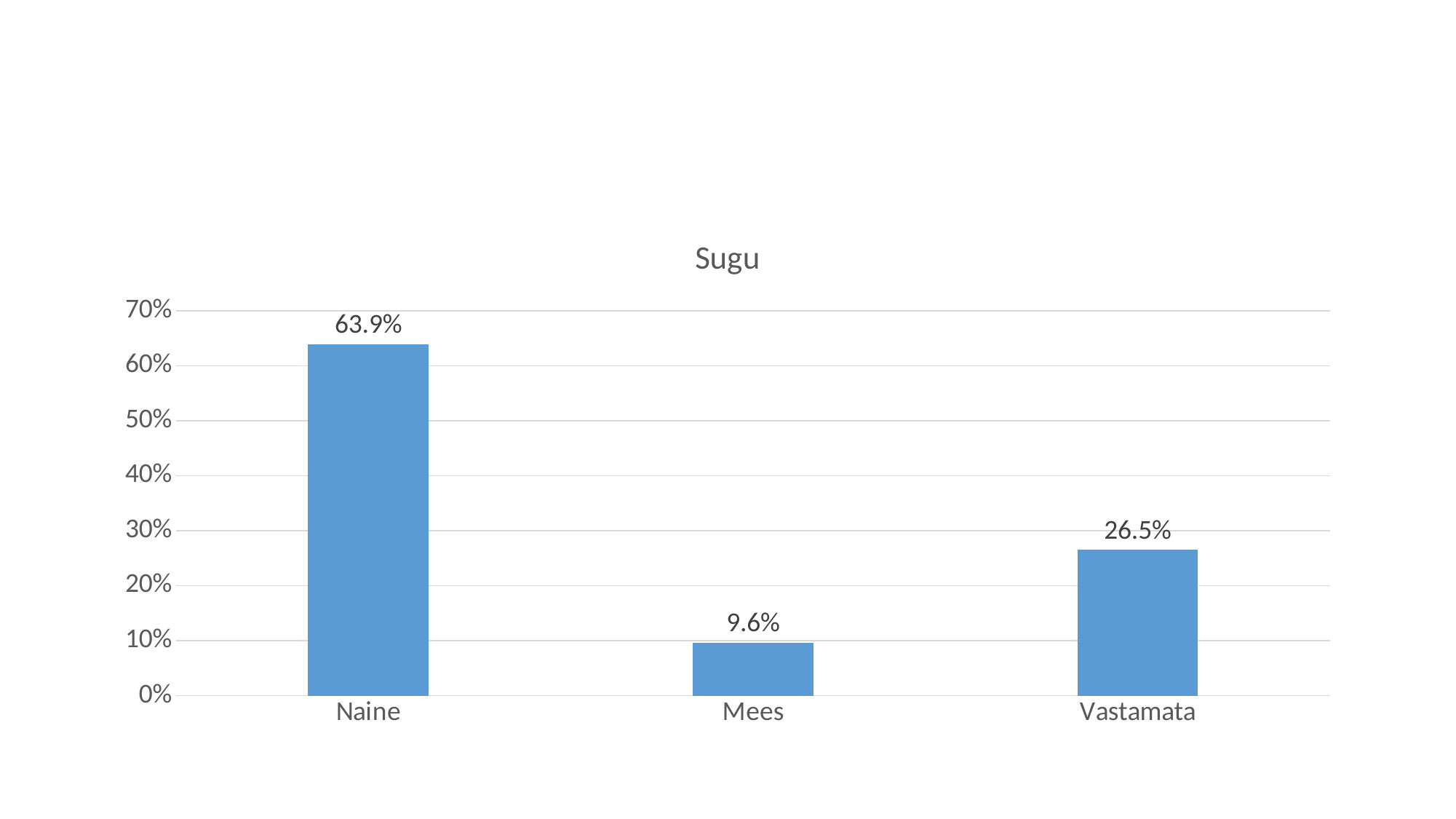
What is the value for Vastamata? 26.5% Is the value for Naine greater or less than 60%? greater How many categories are shown in the chart? 3 What is the difference between the values for Naine and Vastamata? 37.4% Which category has the highest value? Naine What is the value for Mees? 9.6% Which is larger, the value for Mees or the value for Vastamata? Vastamata What is the value for Naine? 63.9% What is the title of the chart? Sugu What is the difference between the values for Vastamata and Mees? 16.9% Which category has the lowest value? Mees What kind of chart is shown on the slide? bar chart